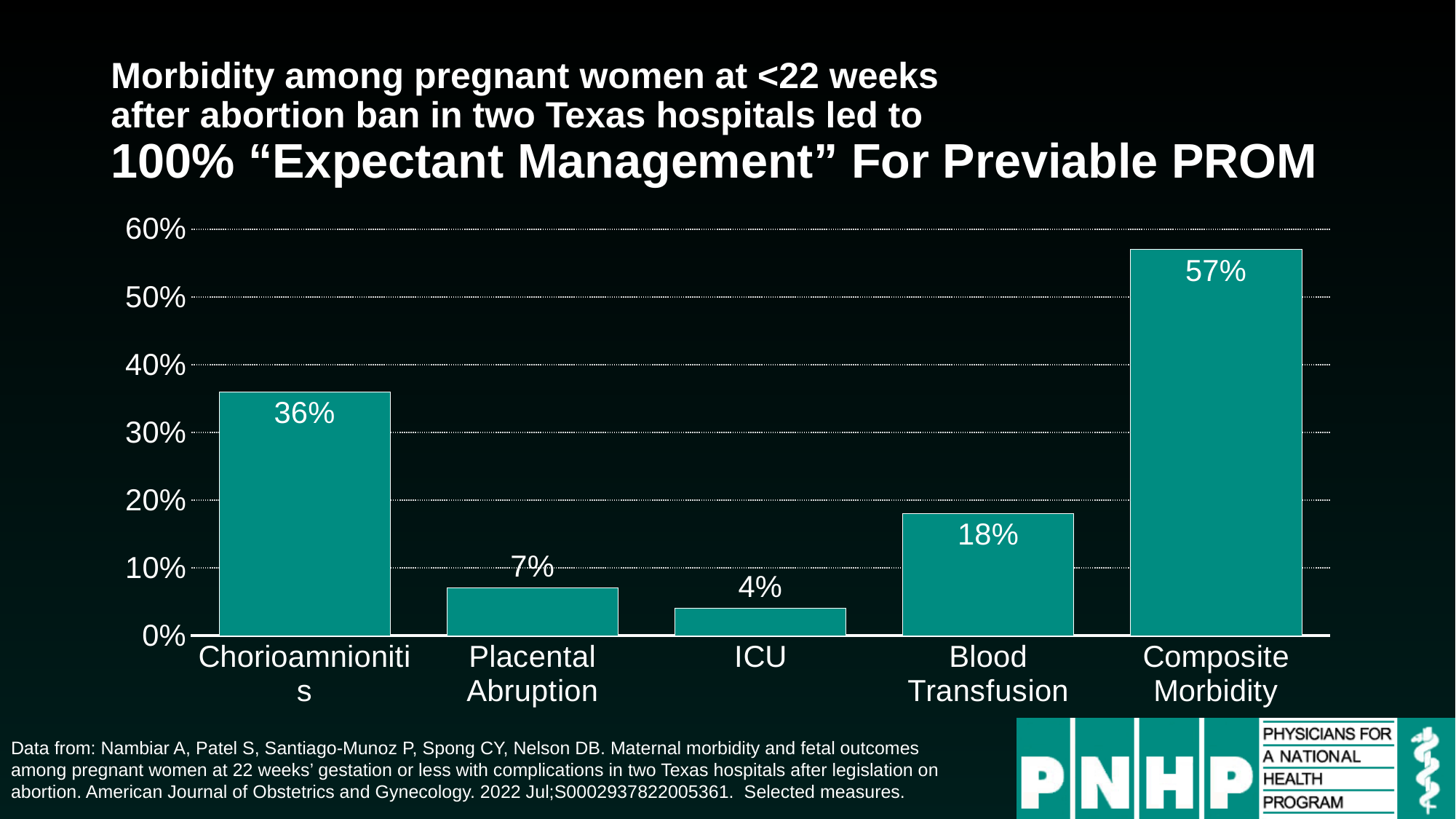
Which category has the lowest value? ICU Which category has the highest value? Composite Morbidity Which is larger, the value for Blood Transfusion or the value for Placental Abruption? Blood Transfusion What is the value for Chorioamnionitis? 36% What is the difference between the values for Composite Morbidity and Chorioamnionitis? 21% How many categories are shown on the chart? 5 What is the value for Placental Abruption? 7% What is the value for Blood Transfusion? 18% What is the value for Composite Morbidity? 57% What kind of chart is shown on the slide? Bar chart Is the value for Chorioamnionitis greater or less than 30%? greater What is the value for ICU? 4%